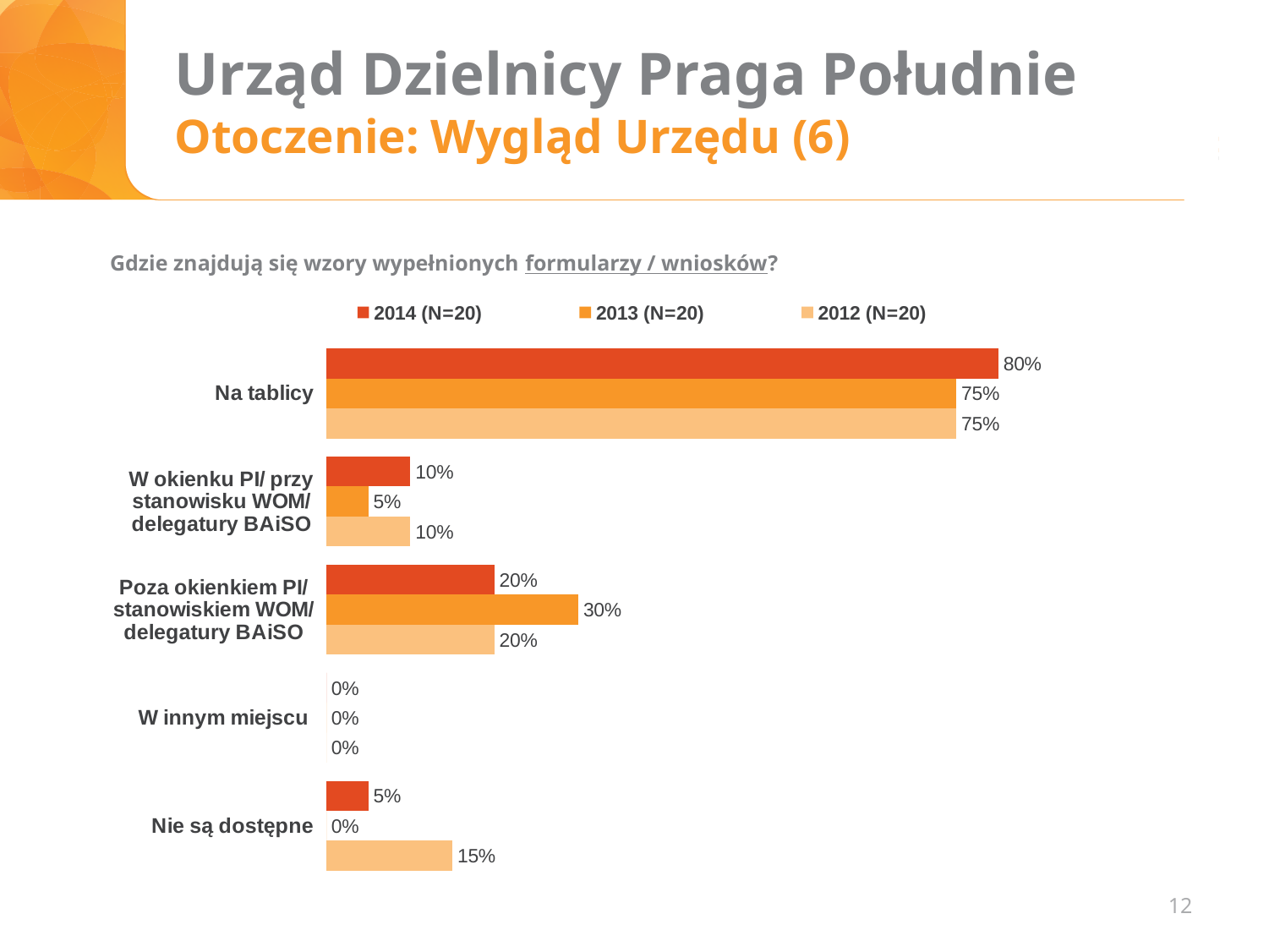
What question does the chart answer, as written above it? Gdzie znajdują się wzory wypełnionych formularzy / wniosków? What is the value for 'W okienku PI/ przy stanowisku WOM/ delegatury BAiSO' in the 2013 (N=20) series? 5% How many series does the legend list? 3 What is the difference between the 2014 (N=20) and 2013 (N=20) values for 'Na tablicy'? 5% What is the value for 'Na tablicy' in the 2014 (N=20) series? 80% What is the value for 'Poza okienkiem PI/ stanowiskiem WOM/ delegatury BAiSO' in the 2013 (N=20) series? 30% Which category has the highest value in the 2014 (N=20) series? Na tablicy Which category has the lowest value in the 2012 (N=20) series? W innym miejscu Which is larger for 'Nie są dostępne': the 2014 (N=20) value or the 2012 (N=20) value? 2012 (N=20) What kind of chart is shown on the slide? bar chart How many categories are shown on the chart? 5 What is the value for 'Nie są dostępne' in the 2012 (N=20) series? 15%